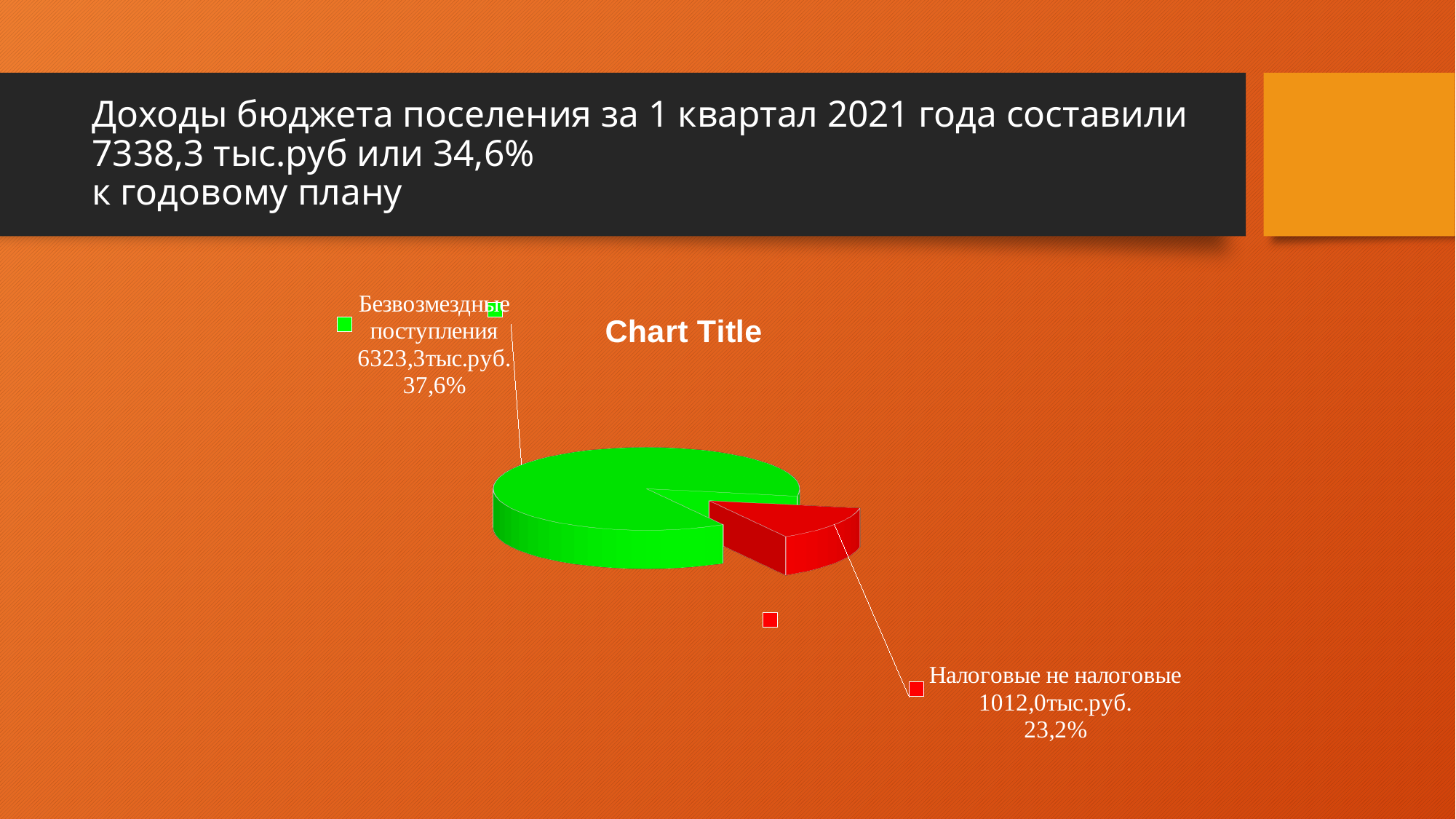
What percentage is printed next to Безвозмездные поступления? 37,6% What colour is the slice for Налоговые не налоговые? Red How many slices does the pie chart have? 2 What value in тыс.руб. is shown for Налоговые не налоговые? 1012,0тыс.руб. What is the title of the chart? Chart Title What kind of chart is shown on the slide? Pie chart Which slice of the pie chart is the largest? Безвозмездные поступления What value in тыс.руб. is shown for Безвозмездные поступления? 6323,3тыс.руб. What is the difference in тыс.руб. between Безвозмездные поступления and Налоговые не налоговые? 5311,3 тыс.руб. Which is larger, Безвозмездные поступления or Налоговые не налоговые? Безвозмездные поступления What percentage is printed next to Налоговые не налоговые? 23,2% Which slice of the pie chart is the smallest? Налоговые не налоговые